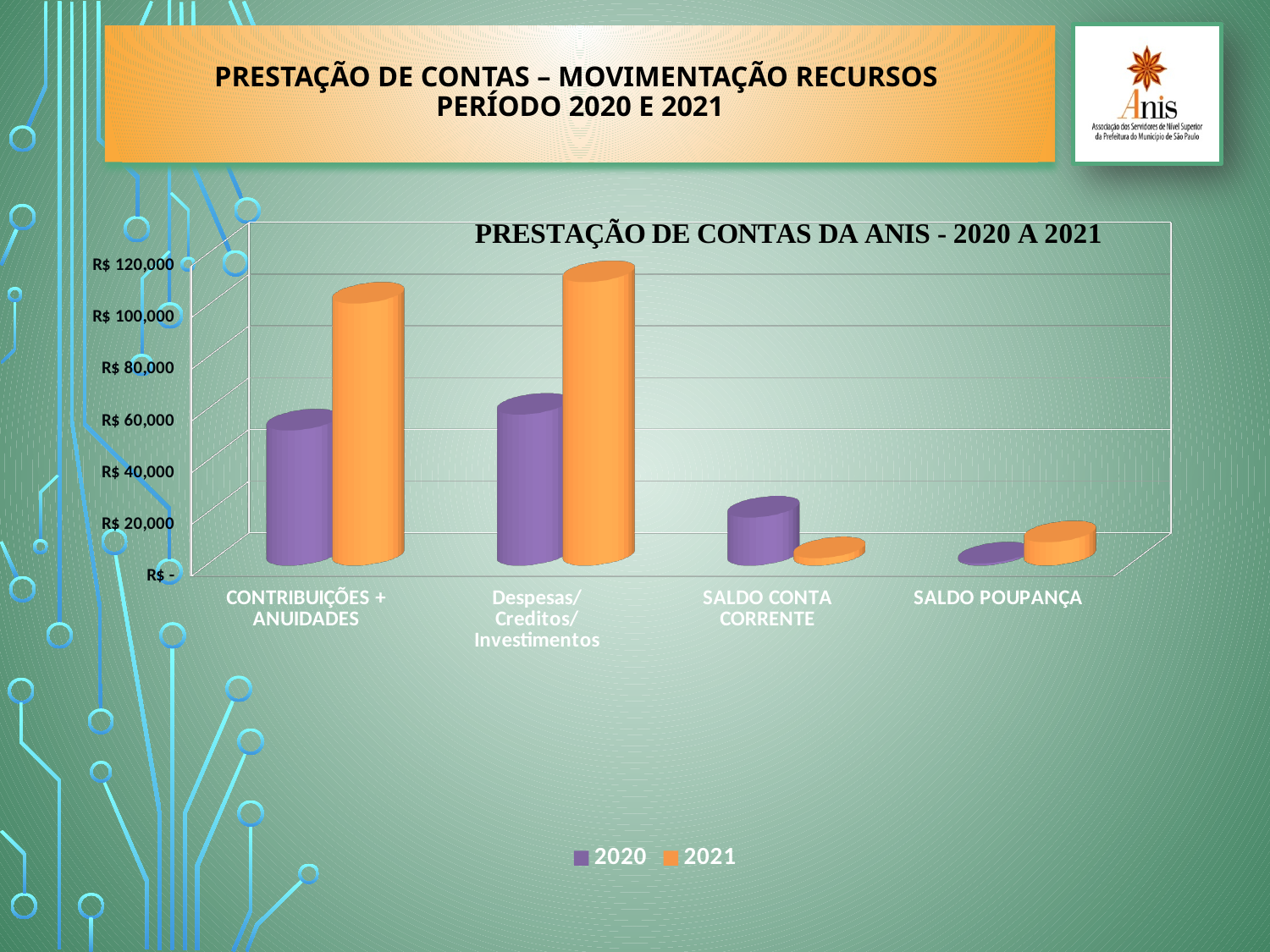
How many categories are shown on the x axis? 4 Is the 2020 value for SALDO CONTA CORRENTE greater or less than R$ 40,000? less Which category has the lowest value for the 2020 series? SALDO POUPANÇA How many series does the legend list? 2 What type of chart is shown on the slide? bar chart For SALDO CONTA CORRENTE, which series has the larger value, 2020 or 2021? 2020 What is the title of the chart? PRESTAÇÃO DE CONTAS DA ANIS - 2020 A 2021 Is the 2021 value for Despesas/Creditos/Investimentos greater or less than R$ 100,000? greater Which category has the lowest value for the 2021 series? SALDO CONTA CORRENTE Which colour represents the 2021 series in the legend? orange Which category has the highest value for the 2021 series? Despesas/Creditos/Investimentos For CONTRIBUIÇÕES + ANUIDADES, which series has the larger value, 2020 or 2021? 2021